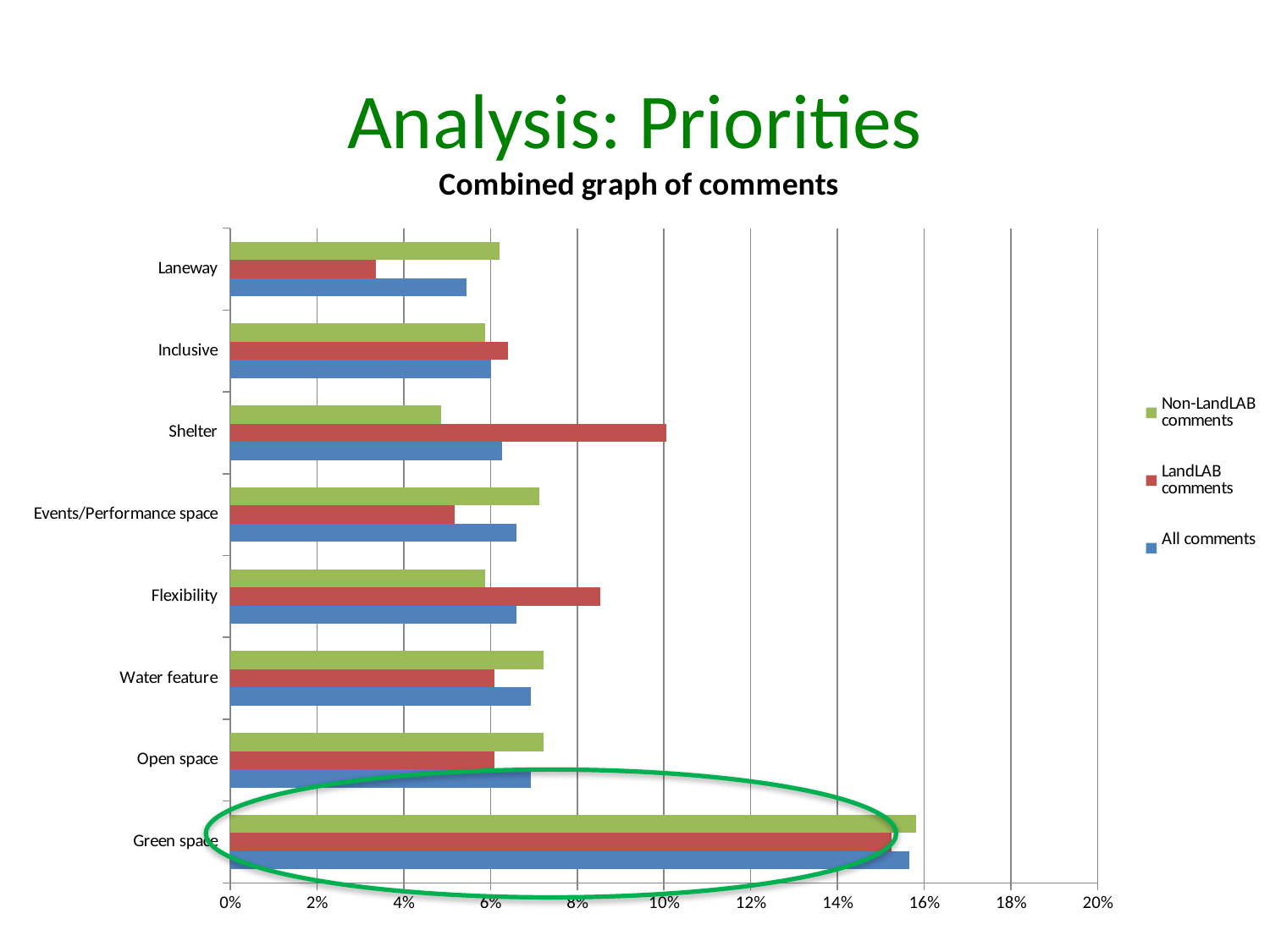
Which category has the highest value for All comments? Green space For Shelter, which is larger: LandLAB comments or Non-LandLAB comments? LandLAB comments Which category has the lowest value for Non-LandLAB comments? Shelter Is the value for Shelter in the Non-LandLAB comments series greater or less than 6%? less Is the value for Flexibility in the LandLAB comments series greater or less than 8%? greater What is the title of the chart? Combined graph of comments For Events/Performance space, which is larger: Non-LandLAB comments or LandLAB comments? Non-LandLAB comments How many categories are shown on the chart? 8 How many series does the legend list? 3 Is the value for Green space in the All comments series greater or less than 14%? greater What kind of chart is shown on the slide? Bar chart Which category has the lowest value for LandLAB comments? Laneway